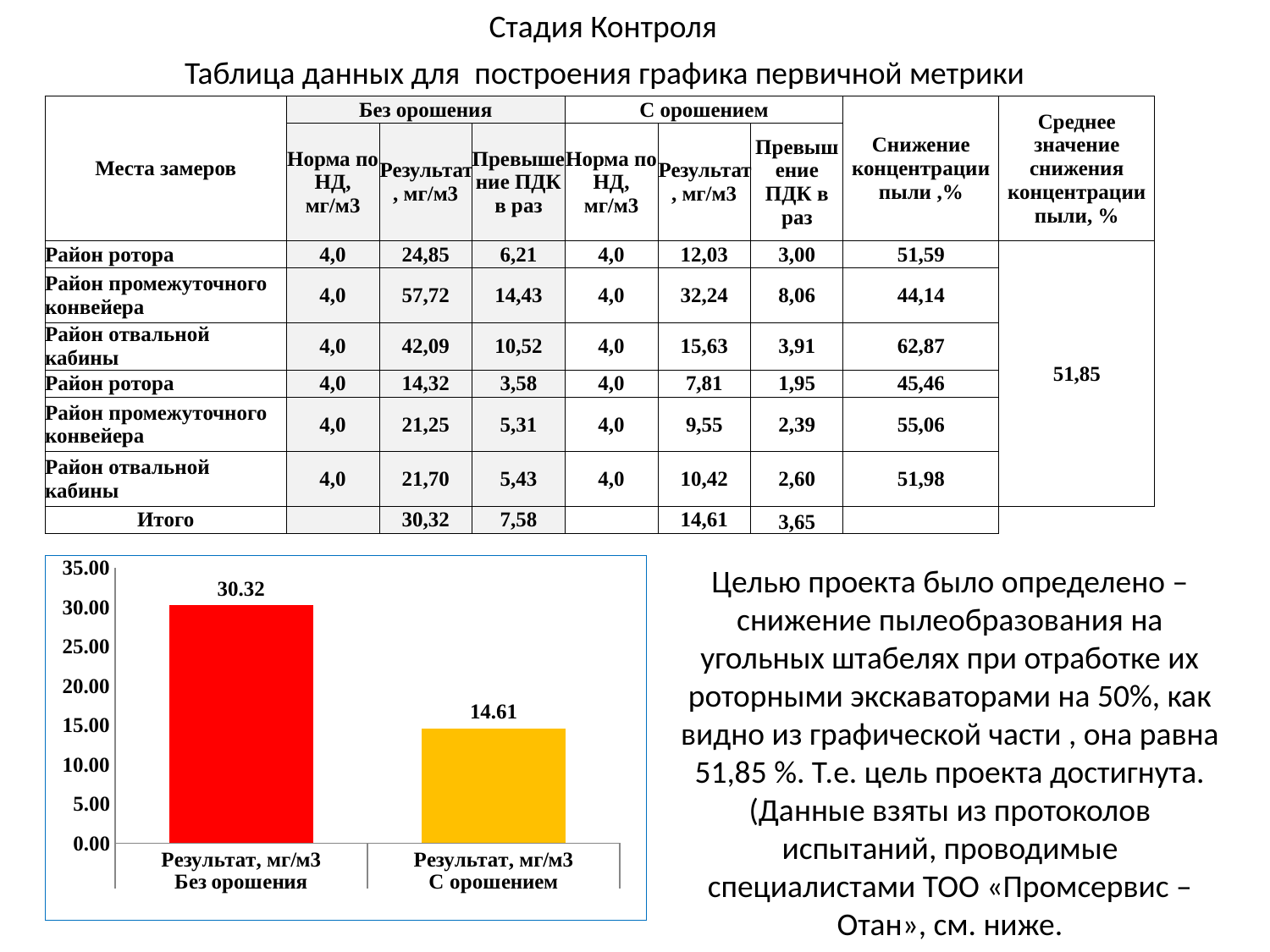
Is the value for "Результат, мг/м3 С орошением" greater or less than 15.00? less What is the difference between the "Без орошения" bar and the "С орошением" bar? 15.71 Is the value for "Результат, мг/м3 Без орошения" greater or less than 30.00? greater Which is larger: the "Без орошения" bar or the "С орошением" bar? Без орошения What is the value of the bar labelled "Результат, мг/м3 Без орошения"? 30.32 What type of chart is shown on the slide? bar chart How many bars are plotted in the chart? 2 What colour is the bar for "Результат, мг/м3 Без орошения"? red Which bar is the lowest in the chart? Результат, мг/м3 С орошением Which bar is the highest in the chart? Результат, мг/м3 Без орошения What is the maximum value shown on the chart's vertical axis? 35.00 What is the value of the bar labelled "Результат, мг/м3 С орошением"? 14.61